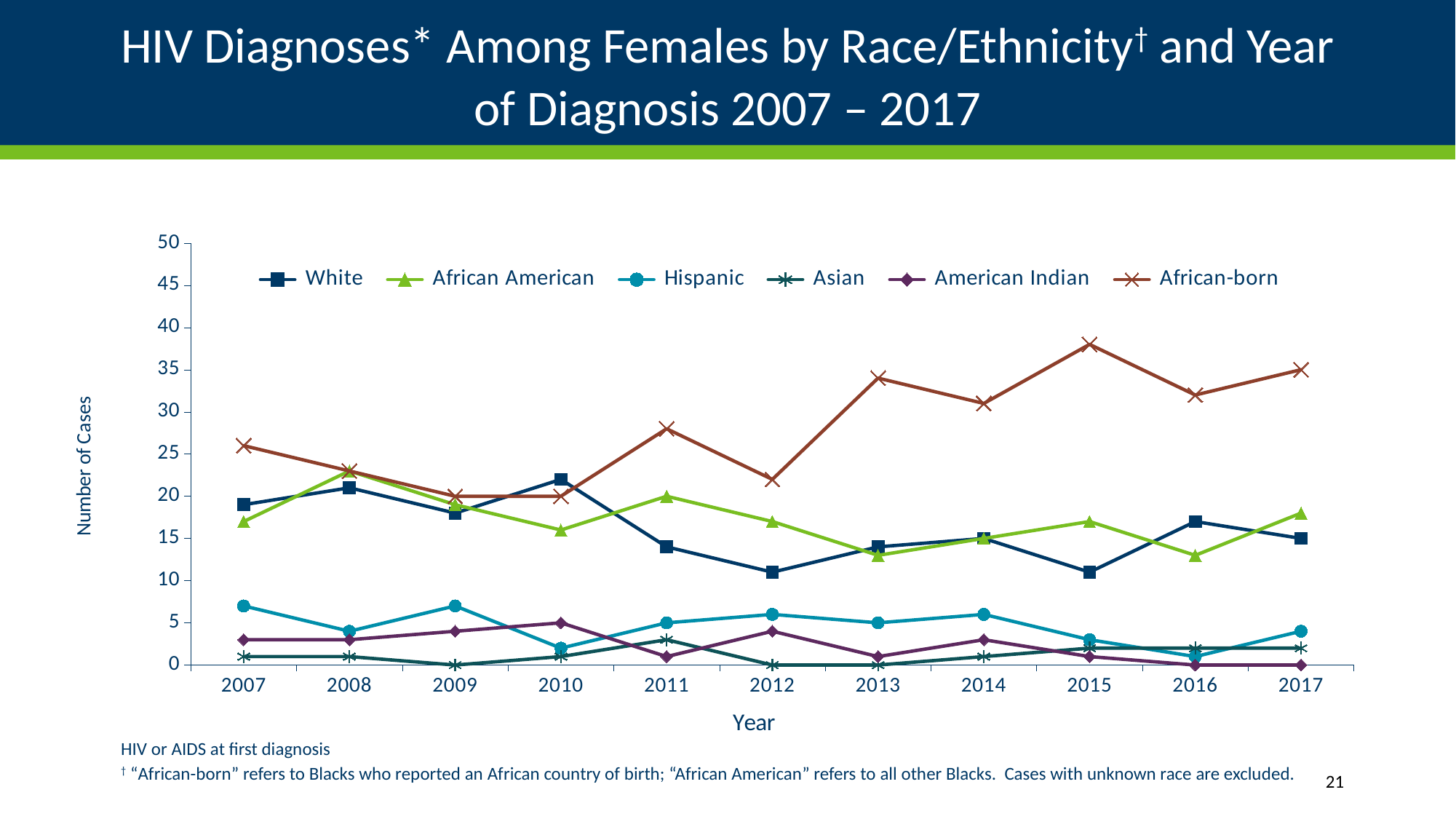
What is the number of cases for Asian in 2012? 0 How many years are plotted along the x axis? 11 What kind of chart is shown on the slide? line chart What is the title of the x axis? Year Is the value for African American in 2008 greater or less than 20? greater Is the value for African-born in 2015 greater or less than 35? greater Which race/ethnicity group has the highest number of cases in 2017? African-born Is the value for White in 2012 greater or less than 15? less Which race/ethnicity group has the lowest number of cases in 2017? American Indian In 2008, which group has more cases, White or Hispanic? White Does the African-born line rise or fall from 2012 to 2013? rise How many series does the legend list? 6